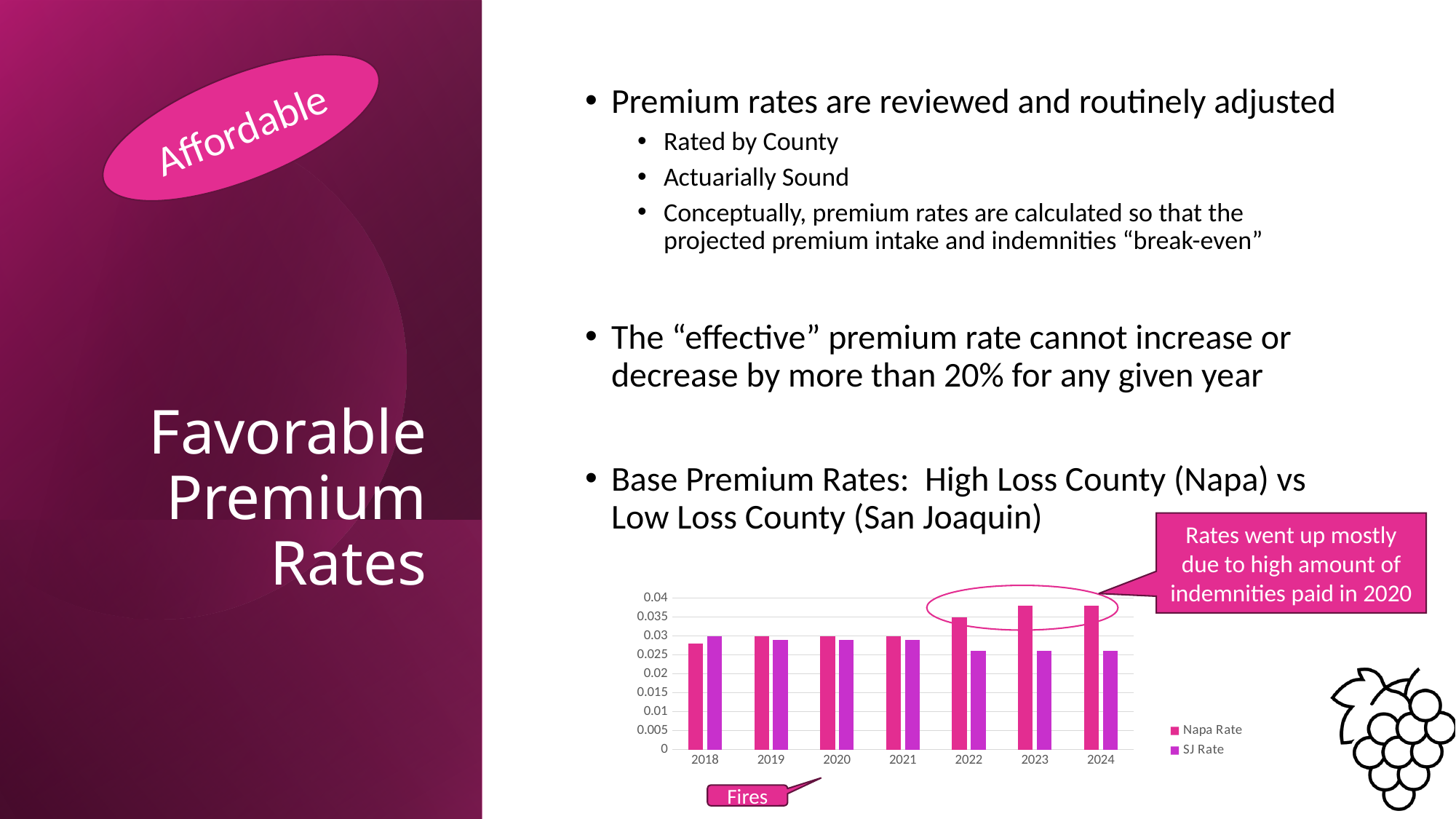
In 2018, which is larger, the Napa Rate or the SJ Rate? SJ Rate Is the SJ Rate for 2023 greater or less than 0.03? less Which series are listed in the chart legend? Napa Rate and SJ Rate What kind of chart is shown on the slide? bar chart Is the Napa Rate for 2023 greater or less than 0.035? greater How many years are shown on the x axis of the chart? 7 How many series does the chart legend list? 2 Is the Napa Rate for 2018 greater or less than 0.03? less Does the Napa Rate generally rise or fall from 2018 to 2024? rise In which year is the Napa Rate lowest? 2018 In 2023, which is larger, the Napa Rate or the SJ Rate? Napa Rate